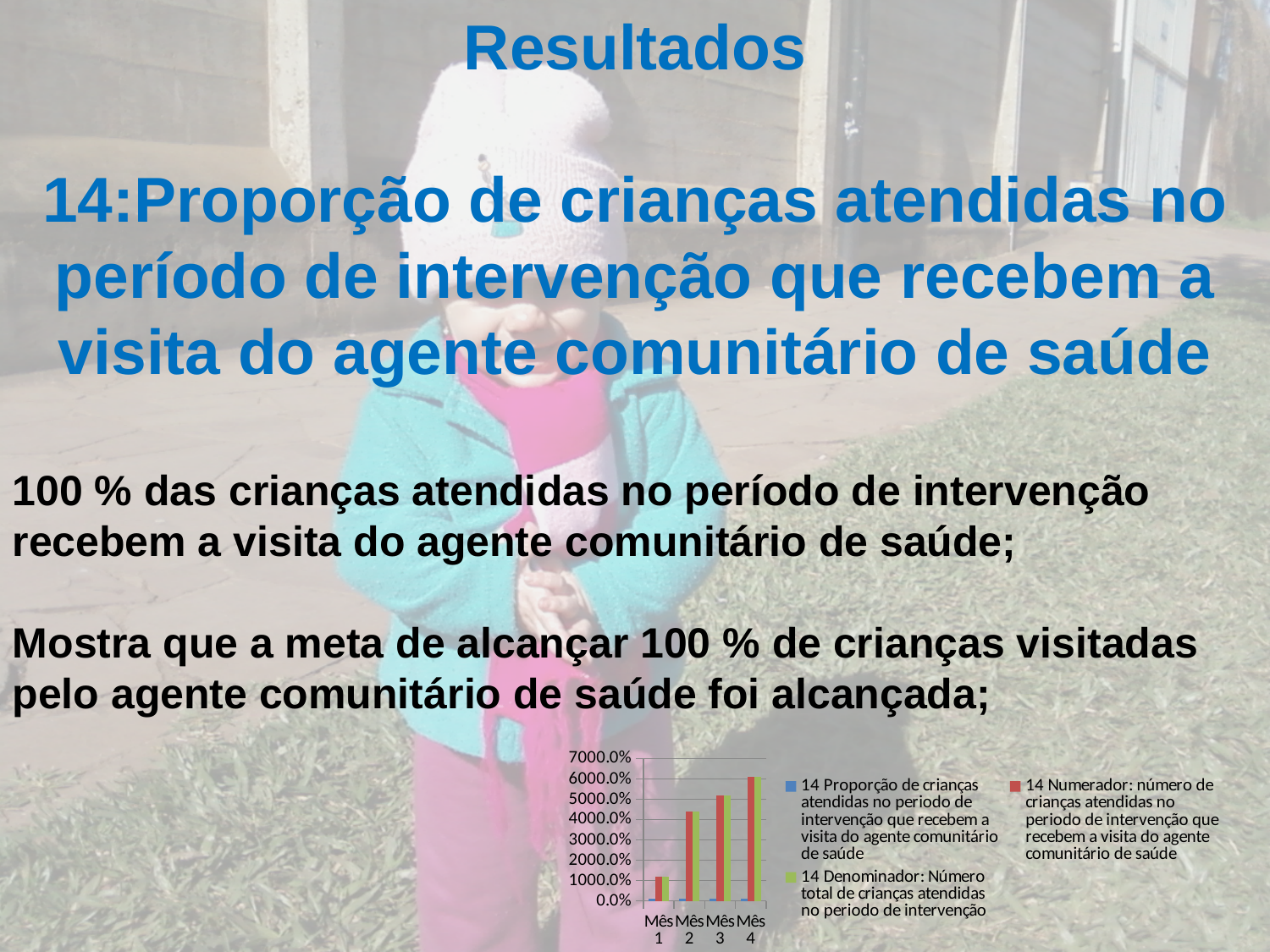
Which is larger in the '14 Denominador' series: the value for Mês 1 or the value for Mês 4? Mês 4 How many categories (months) are shown on the x axis of the chart? 4 Which month has the highest value for the series '14 Numerador: número de crianças atendidas no periodo de intervenção que recebem a visita do agente comunitário de saúde'? Mês 4 Is the value for Mês 4 in the '14 Numerador' series greater or less than 5000.0%? greater What kind of chart is shown on the slide? bar chart What colour represents the series '14 Numerador: número de crianças atendidas no periodo de intervenção que recebem a visita do agente comunitário de saúde' in the legend? red Which month has the lowest value for the series '14 Denominador: Número total de crianças atendidas no periodo de intervenção'? Mês 1 How many series does the chart's legend list? 3 Is the value for Mês 2 in the '14 Numerador' series greater or less than 3000.0%? greater Do the values of the '14 Numerador' series rise or fall from Mês 1 to Mês 4? rise Is the value for Mês 1 in the '14 Denominador' series greater or less than 2000.0%? less What is the highest tick value shown on the chart's vertical axis? 7000.0%